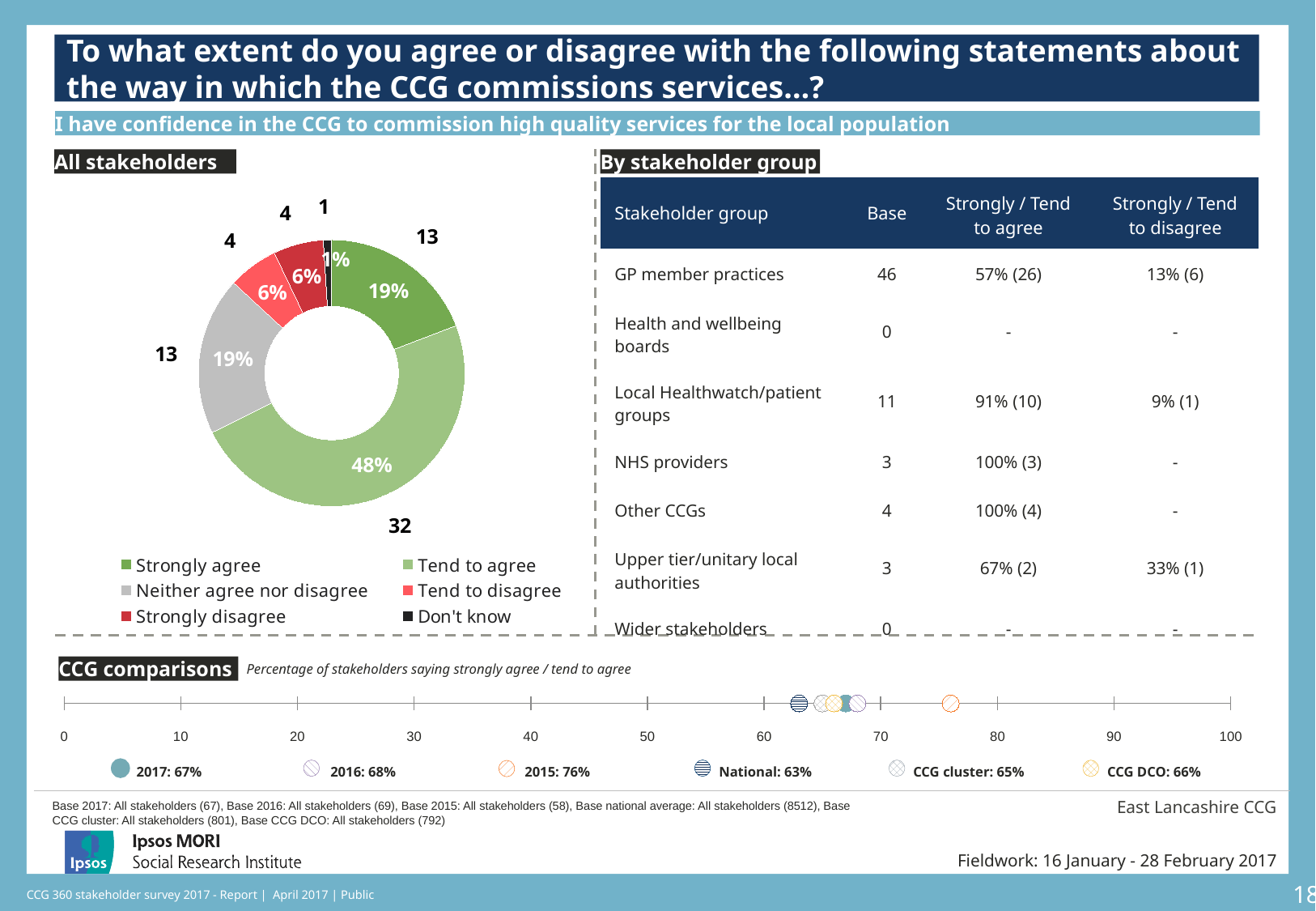
In the 'CCG comparisons' chart, is the 2017 value larger or the National value larger? 2017 In the 'All stakeholders' donut chart, what percentage of stakeholders said 'Tend to agree'? 48% What type of chart is used for the 'All stakeholders' section? Donut (pie) chart In the 'All stakeholders' donut chart, how many stakeholders answered 'Don't know'? 1 In the 'CCG comparisons' chart, what percentage of stakeholders said strongly agree / tend to agree in 2017? 67% In the 'All stakeholders' donut chart, how many response categories does the legend list? 6 In the 'CCG comparisons' chart, which year or comparator has the highest percentage? 2015: 76% In the 'All stakeholders' donut chart, which response category has the largest share? Tend to agree In the 'All stakeholders' donut chart, what is the difference in percentage points between 'Tend to agree' and 'Neither agree nor disagree'? 29 In the 'All stakeholders' donut chart, what colour represents 'Neither agree nor disagree'? Grey In the 'All stakeholders' donut chart, what percentage of stakeholders said 'Strongly agree'? 19% In the 'All stakeholders' donut chart, which response category has the smallest share? Don't know